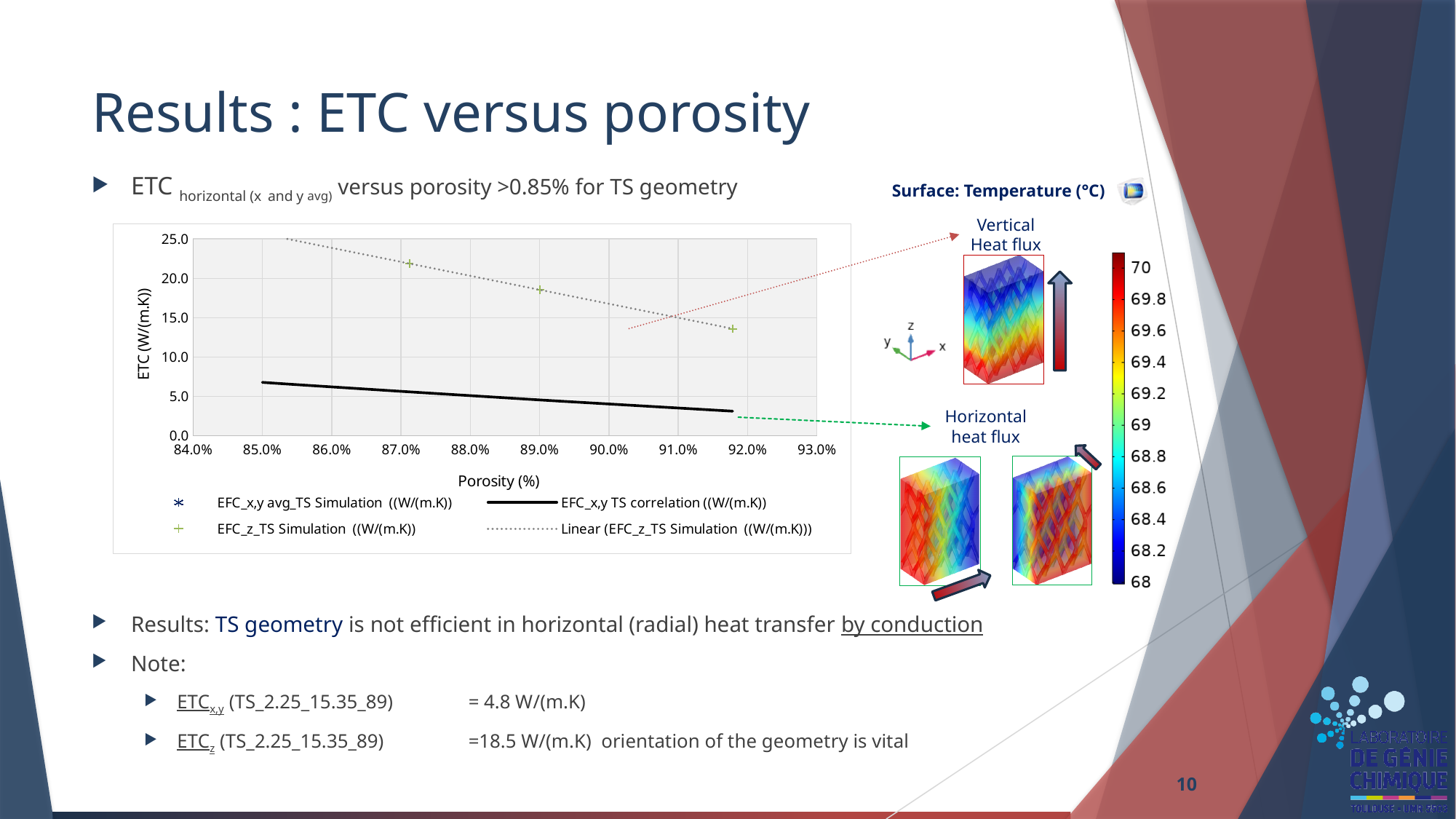
What is the title of the y axis of the chart? ETC (W/(m.K)) Does the Linear (EFC_z_TS Simulation) trend line rise or fall as porosity increases? fall Is the EFC_x,y TS correlation value at about 92% porosity greater or less than 5.0? less How many series does the chart legend list? 4 What is the title of the x axis of the chart? Porosity (%) Is the EFC_z_TS Simulation value at about 87% porosity greater or less than 20.0? greater Is the EFC_z_TS Simulation value at about 92% porosity greater or less than 15.0? less What kind of chart is shown on the slide? line chart How many EFC_z_TS Simulation data points are plotted on the chart? 3 Does the EFC_x,y TS correlation line rise or fall as porosity increases? fall Which series has higher ETC values across the plotted porosity range, EFC_z_TS Simulation or EFC_x,y TS correlation? EFC_z_TS Simulation